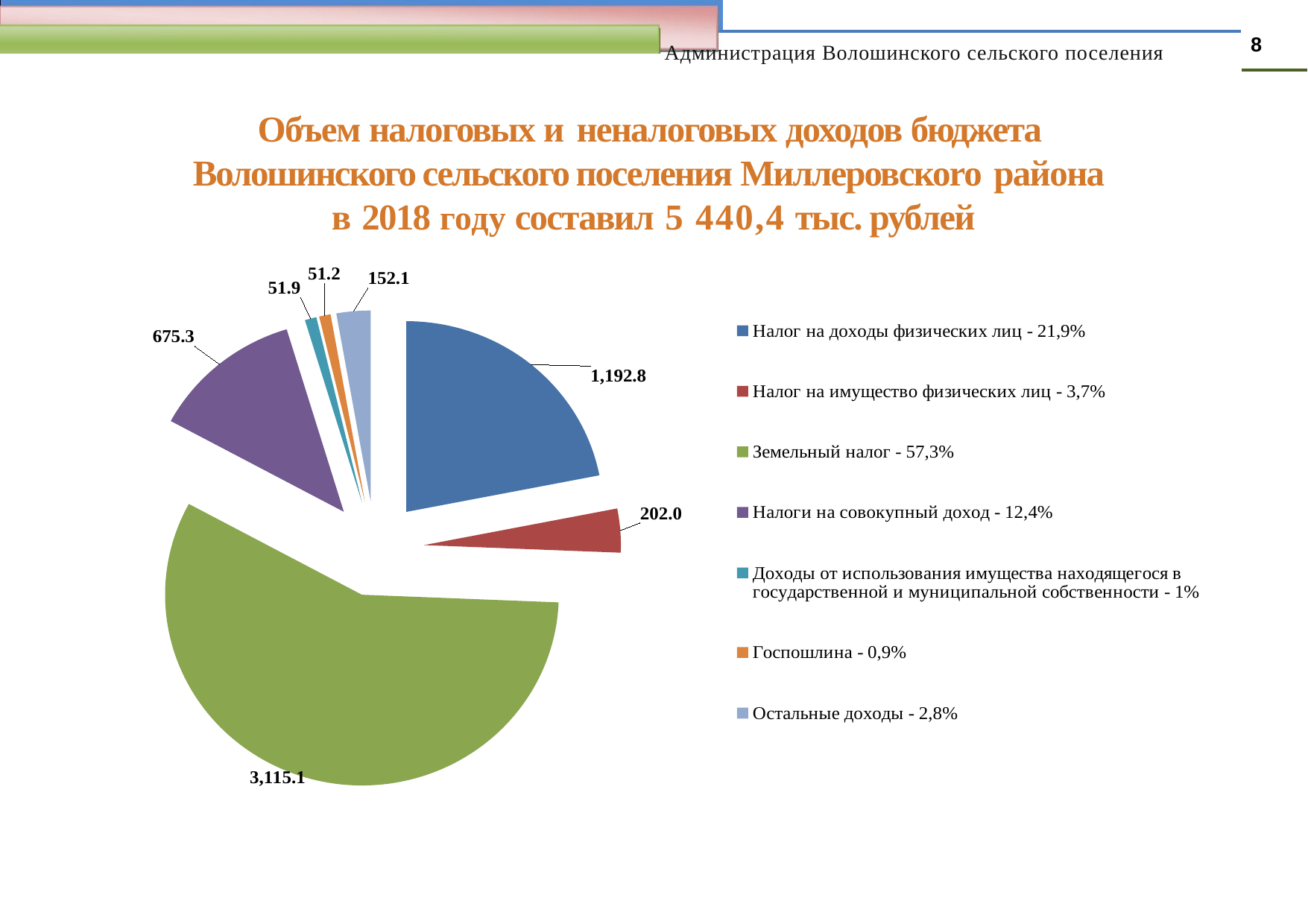
What is the value shown for Госпошлина? 51.2 Which is larger: the value for Налог на имущество физических лиц or the value for Остальные доходы? Налог на имущество физических лиц What is the value shown for Налоги на совокупный доход? 675.3 What is the value shown for Земельный налог? 3,115.1 What share of the pie does Земельный налог represent, according to the legend? 57,3% How many slices does the pie chart have? 7 What kind of chart is shown on the slide? Pie chart How many entries does the legend list? 7 What is the value shown for Налог на доходы физических лиц? 1,192.8 What is the difference between the values for Налог на доходы физических лиц and Налоги на совокупный доход? 517.5 Which category has the largest slice of the pie? Земельный налог Which category has the smallest slice of the pie? Госпошлина